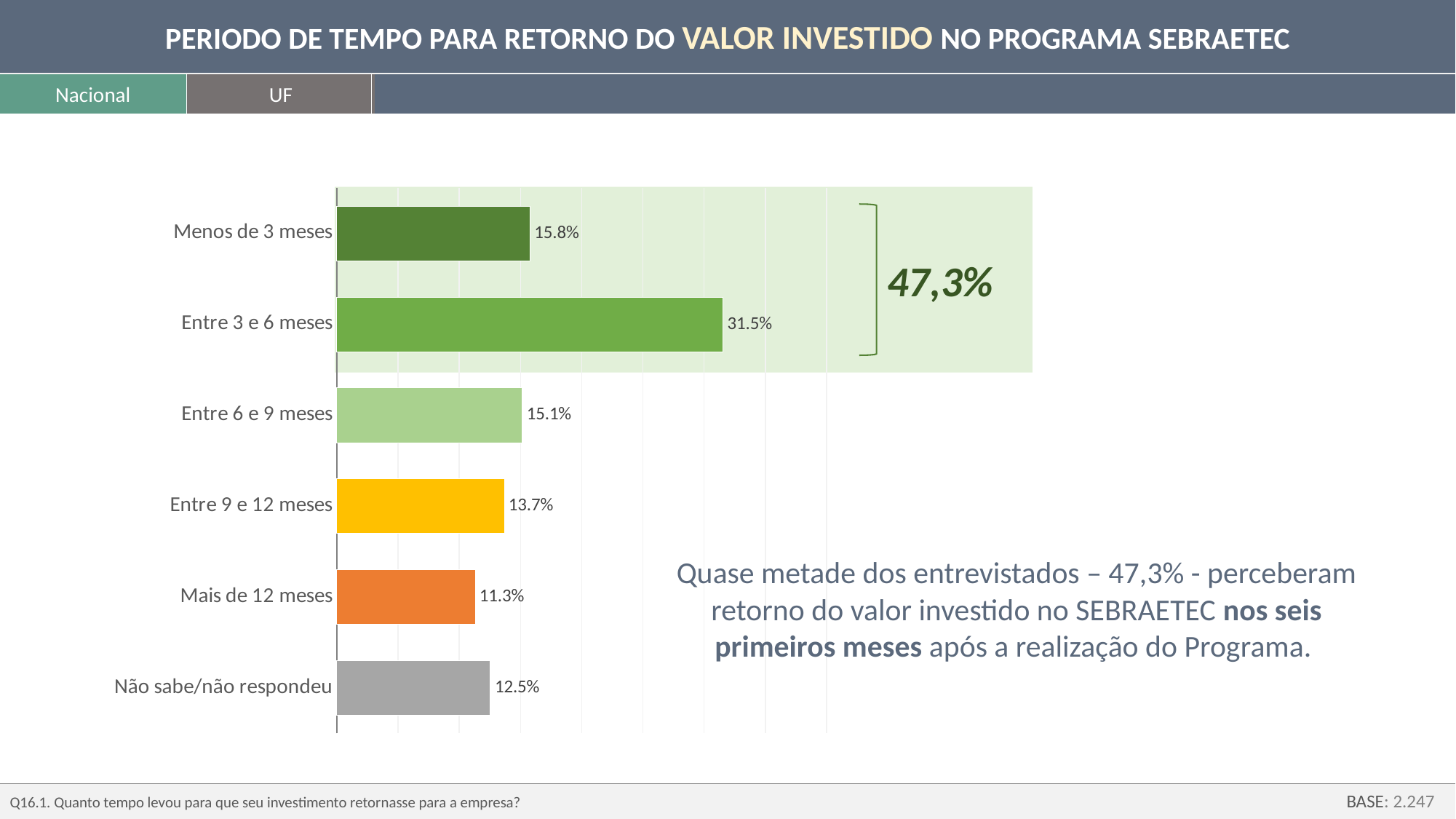
Which is larger, the value for "Entre 9 e 12 meses" or the value for "Não sabe/não respondeu"? Entre 9 e 12 meses Which category has the highest value? Entre 3 e 6 meses What is the value for "Menos de 3 meses"? 15.8% What is the difference between the values for "Entre 3 e 6 meses" and "Menos de 3 meses"? 15.7% What is the value for "Mais de 12 meses"? 11.3% What kind of chart is shown on the slide? Bar chart What is the value for "Entre 3 e 6 meses"? 31.5% What is the value for "Não sabe/não respondeu"? 12.5% What colour is the bar for "Entre 9 e 12 meses"? Yellow How many categories are shown in the chart? 6 Which category has the lowest value? Mais de 12 meses What is the combined value for "Menos de 3 meses" and "Entre 3 e 6 meses" shown by the bracket on the chart? 47,3%